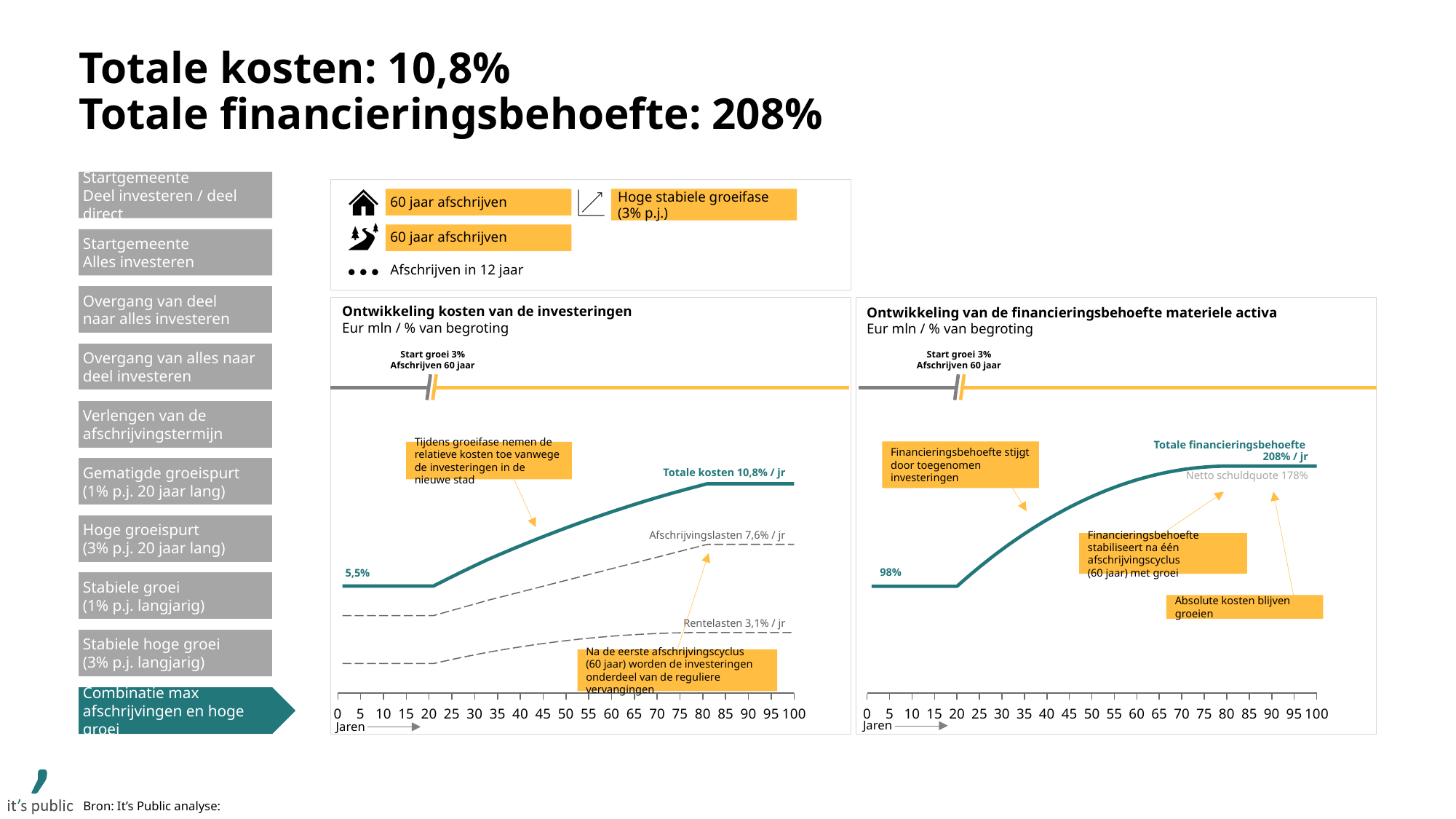
What kind of chart is the left chart 'Ontwikkeling kosten van de investeringen'? line chart On the left chart 'Ontwikkeling kosten van de investeringen', by how much does the Totale kosten line rise from its starting value to its final value? 5,3% On the left chart 'Ontwikkeling kosten van de investeringen', what is the starting value of the Totale kosten line? 5,5% On the left chart 'Ontwikkeling kosten van de investeringen', what is the final value of the Rentelasten line? 3,1% / jr On the left chart 'Ontwikkeling kosten van de investeringen', how many lines are plotted? 3 On the right chart 'Ontwikkeling van de financieringsbehoefte materiele activa', does the line rise or fall along the x axis? rise On the right chart 'Ontwikkeling van de financieringsbehoefte materiele activa', what is the Netto schuldquote shown? 178% On the right chart 'Ontwikkeling van de financieringsbehoefte materiele activa', what is the starting value of the line? 98% On the left chart 'Ontwikkeling kosten van de investeringen', which ends higher: Afschrijvingslasten or Rentelasten? Afschrijvingslasten On the right chart 'Ontwikkeling van de financieringsbehoefte materiele activa', what is the Totale financieringsbehoefte at the end? 208% / jr On the left chart 'Ontwikkeling kosten van de investeringen', what is the final value of the Totale kosten line? 10,8% / jr On the left chart 'Ontwikkeling kosten van de investeringen', what is the final value of the Afschrijvingslasten line? 7,6% / jr